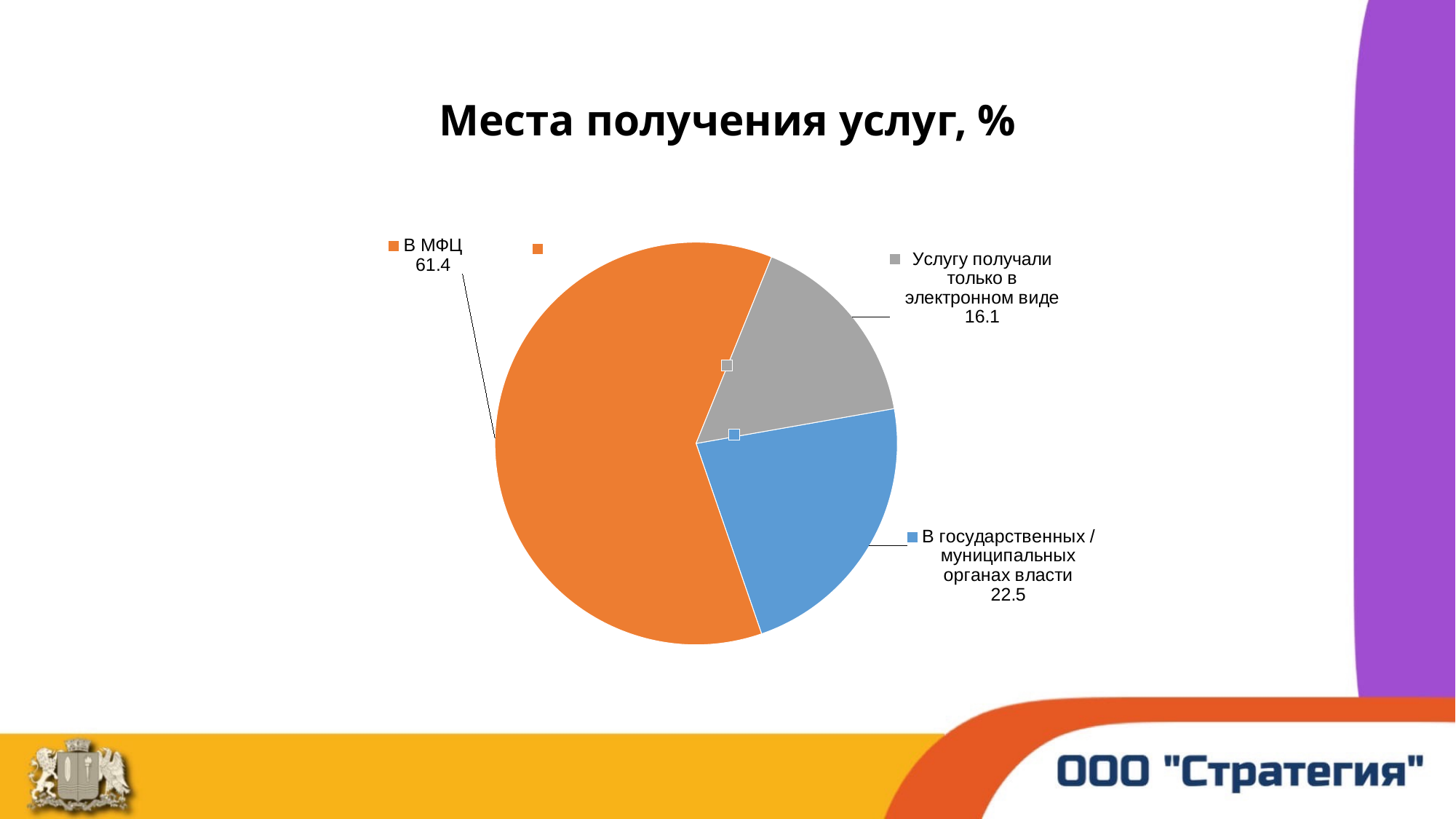
What is the value for "В МФЦ"? 61.4 What is the value for "Услугу получали только в электронном виде"? 16.1 Which is larger: "В государственных / муниципальных органах власти" or "Услугу получали только в электронном виде"? В государственных / муниципальных органах власти How many slices does the pie chart have? 3 What is the difference between the values for "В МФЦ" and "В государственных / муниципальных органах власти"? 38.9 Which category has the smallest slice of the pie? Услугу получали только в электронном виде What is the difference between the values for "В государственных / муниципальных органах власти" and "Услугу получали только в электронном виде"? 6.4 What kind of chart is shown on the slide? Pie chart What colour is the slice for "В МФЦ"? Orange What is the title of the chart? Места получения услуг, % What is the value for "В государственных / муниципальных органах власти"? 22.5 Which category has the largest slice of the pie? В МФЦ